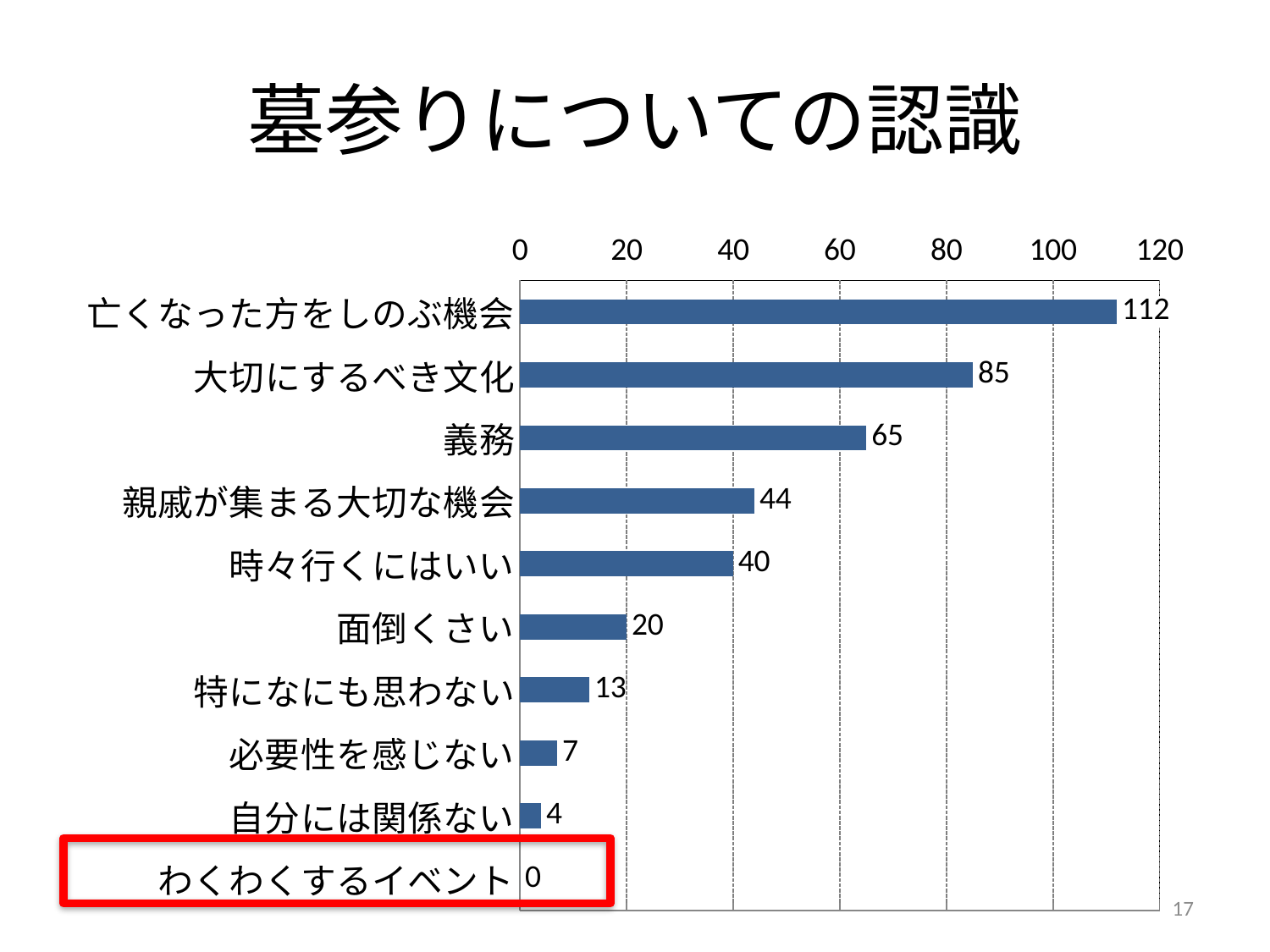
What kind of chart is shown on the slide? Bar chart What is the value for 亡くなった方をしのぶ機会? 112 Which category has the highest value? 亡くなった方をしのぶ機会 What is the value for わくわくするイベント? 0 Which category is highlighted with a red box? わくわくするイベント What is the difference between the values for 大切にするべき文化 and 義務? 20 What is the value for 義務? 65 How many categories are shown in the chart? 10 What is the value for 面倒くさい? 20 What is the title of the slide? 墓参りについての認識 Which category has the lowest value? わくわくするイベント Which is larger, the value for 親戚が集まる大切な機会 or the value for 時々行くにはいい? 親戚が集まる大切な機会